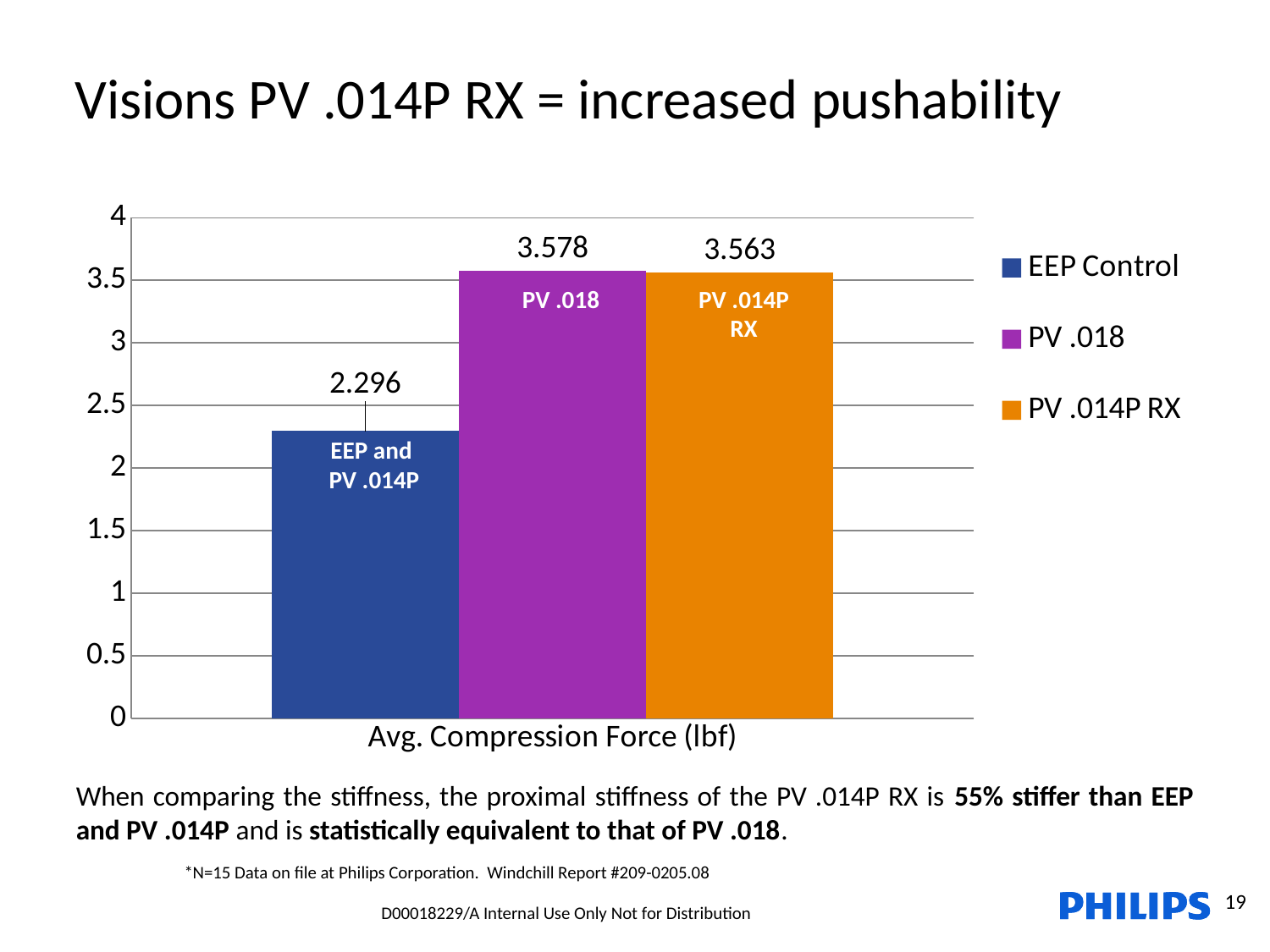
How many series does the legend list? 3 Is the value for EEP Control greater or less than 2.5? less What is the value of the PV .014P RX bar? 3.563 What kind of chart is shown on the slide? bar chart What is the difference between the PV .018 value and the EEP Control value? 1.282 Which series has the lowest average compression force? EEP Control What is the label on the x axis of the chart? Avg. Compression Force (lbf) What is the value of the EEP Control bar? 2.296 What is the difference between the PV .014P RX value and the EEP Control value? 1.267 Is the value for PV .018 greater or less than 3? greater What is the value of the PV .018 bar? 3.578 Which is larger, the EEP Control value or the PV .014P RX value? PV .014P RX